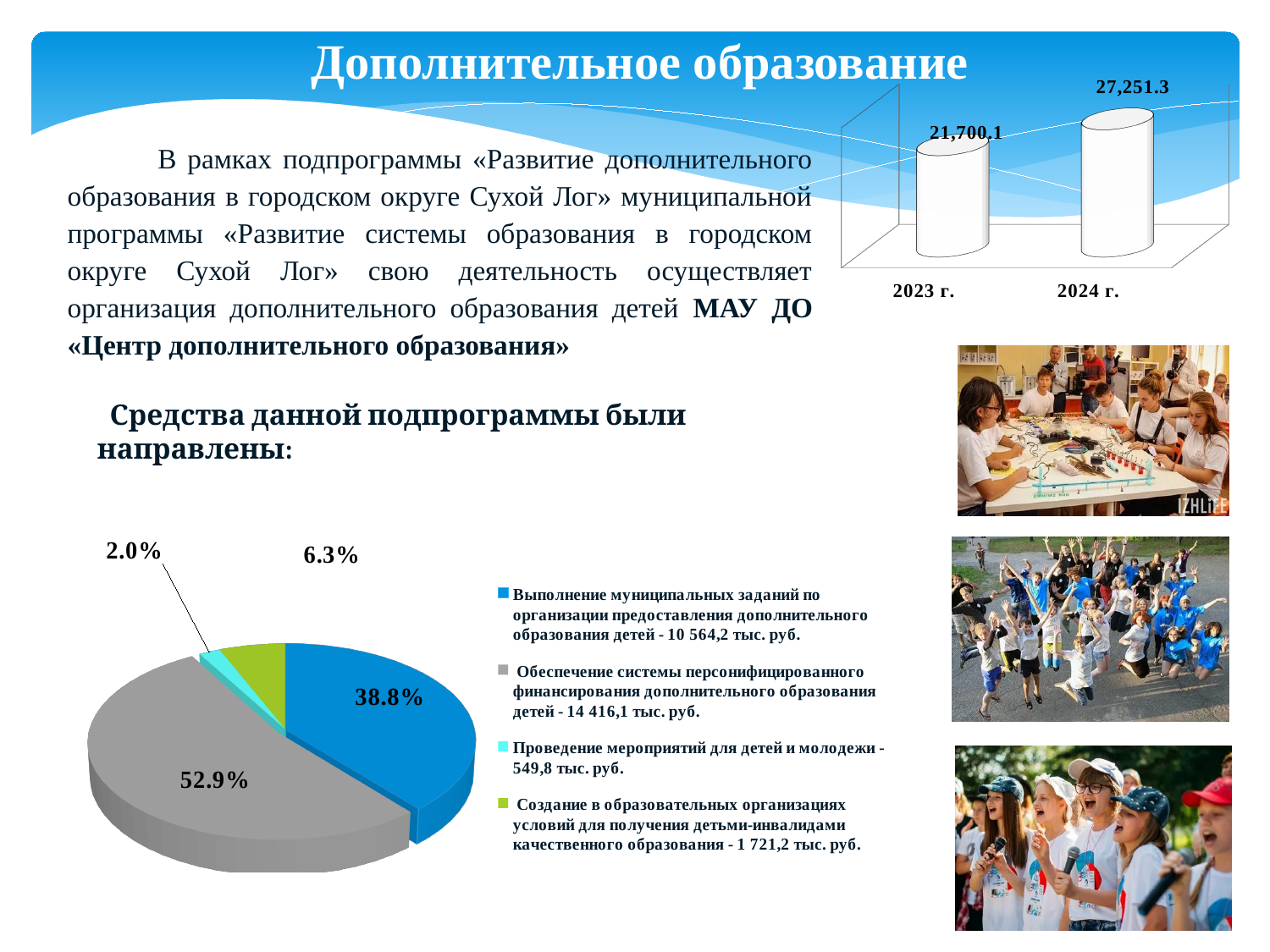
In the pie chart at the bottom left of the slide, what amount does the legend give for «Проведение мероприятий для детей и молодежи»? 549,8 тыс. руб. What type of chart is shown at the top right of the slide? bar chart In the bar chart at the top right of the slide, how many bars are plotted? 2 How many entries does the legend of the pie chart at the bottom left of the slide list? 4 What type of chart is shown at the bottom left of the slide? pie chart In the pie chart at the bottom left of the slide, what is the share of the smallest slice? 2.0% In the bar chart at the top right of the slide, what is the value for 2023 г.? 21,700.1 In the bar chart at the top right of the slide, what is the difference between the 2024 г. and 2023 г. values? 5,551.2 In the bar chart at the top right of the slide, what is the value for 2024 г.? 27,251.3 In the pie chart at the bottom left of the slide, what share does the largest slice have? 52.9% In the bar chart at the top right of the slide, do the values rise or fall from 2023 г. to 2024 г.? rise In the bar chart at the top right of the slide, which year has the higher value? 2024 г.